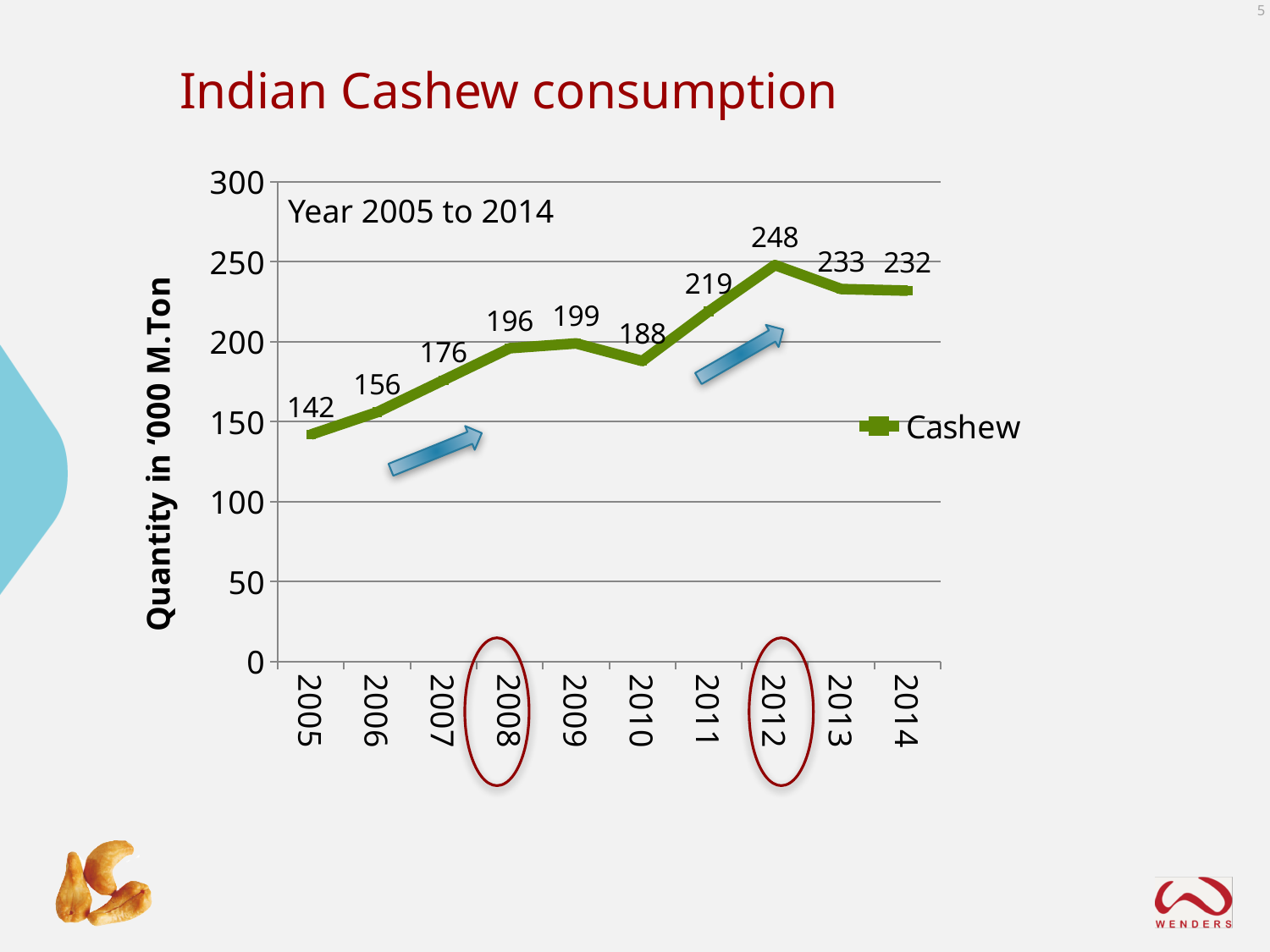
What is the difference between the cashew consumption in 2012 and in 2005? 106 What is the cashew consumption value for 2010? 188 How many years are plotted on the chart? 10 Which year has a higher cashew consumption, 2009 or 2010? 2009 What is the label of the y axis? Quantity in '000 M.Ton Does cashew consumption generally rise or fall from 2005 to 2012? rise Which year has the lowest cashew consumption? 2005 What is the cashew consumption value for 2012? 248 What kind of chart is shown on the slide? line chart What is the cashew consumption value for 2005? 142 Which year has the highest cashew consumption? 2012 How many series does the legend list? 1